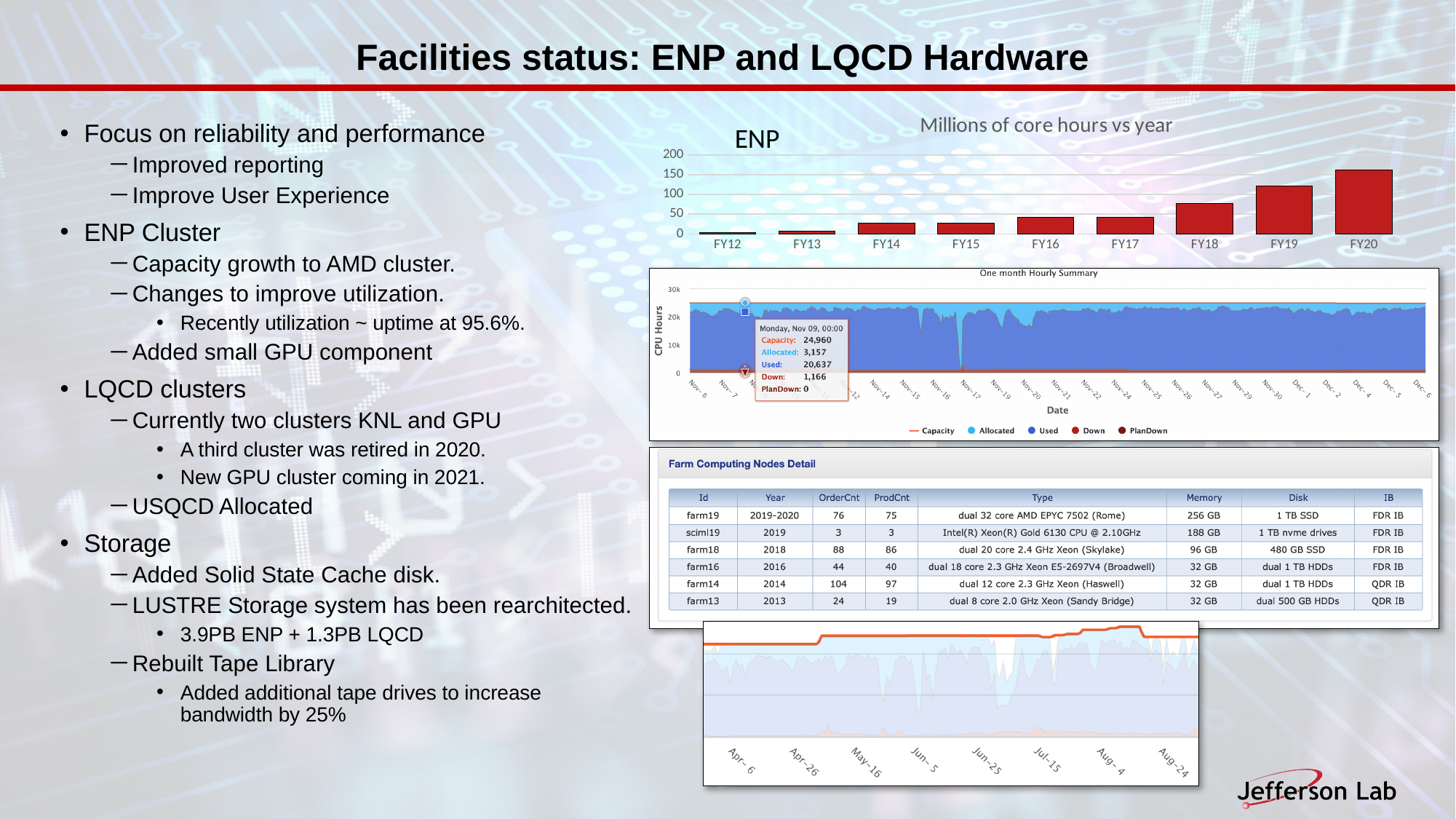
What kind of chart is the 'Millions of core hours vs year' chart? bar chart How many fiscal years are shown on the x axis of the 'Millions of core hours vs year' chart? 9 What is the y-axis label of the 'One month Hourly Summary' chart? CPU Hours In the 'One month Hourly Summary' chart, what Capacity value is shown in the tooltip for Monday, Nov 09, 00:00? 24,960 In the 'Millions of core hours vs year' chart, which is larger, the value for FY19 or the value for FY18? FY19 In the 'Millions of core hours vs year' chart, is the value for FY16 greater or less than 50? less In the 'Millions of core hours vs year' chart, do the values generally rise or fall from FY12 to FY20? rise In the 'One month Hourly Summary' chart, what Used value is shown in the tooltip for Monday, Nov 09, 00:00? 20,637 In the 'Millions of core hours vs year' chart, is the value for FY18 greater or less than 100? less In the 'Millions of core hours vs year' chart, is the value for FY20 greater or less than 150? greater In the 'Millions of core hours vs year' chart, which fiscal year has the highest value? FY20 How many series does the legend of the 'One month Hourly Summary' chart list? 5